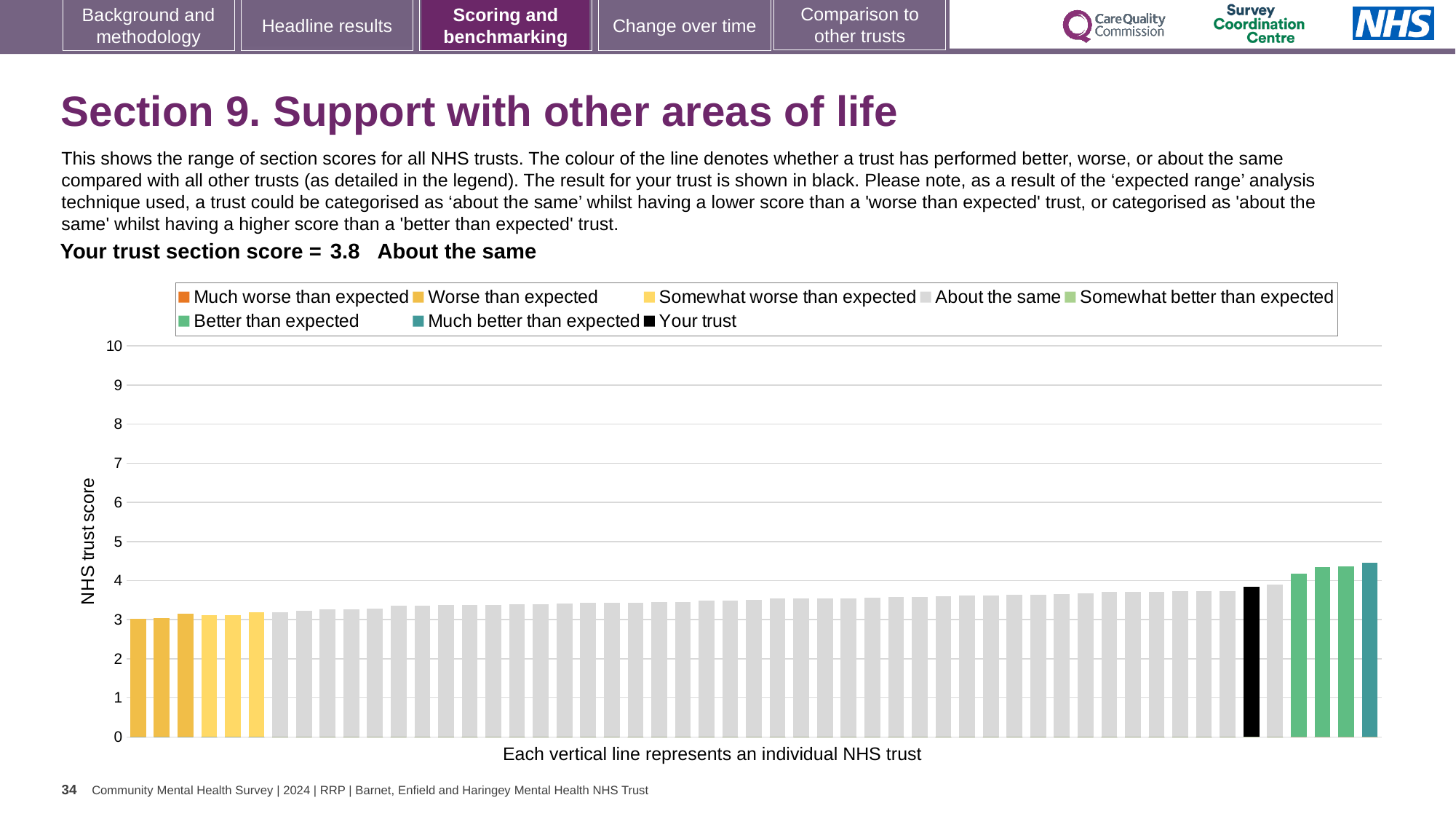
What kind of chart is shown on the slide? bar chart Do the bar values rise or fall from left to right along the x axis? rise What is the section score for your trust? 3.8 What colour is the bar for your trust in the chart? black Is the shortest bar in the chart greater or less than 2? greater Is the value for your trust greater or less than 3? greater Is the value for your trust greater or less than 5? less How many bars are coloured as 'Much better than expected' (teal)? 1 What is the label on the y axis of the chart? NHS trust score How many bars are coloured as 'Better than expected' (green)? 3 How many entries does the chart legend list? 8